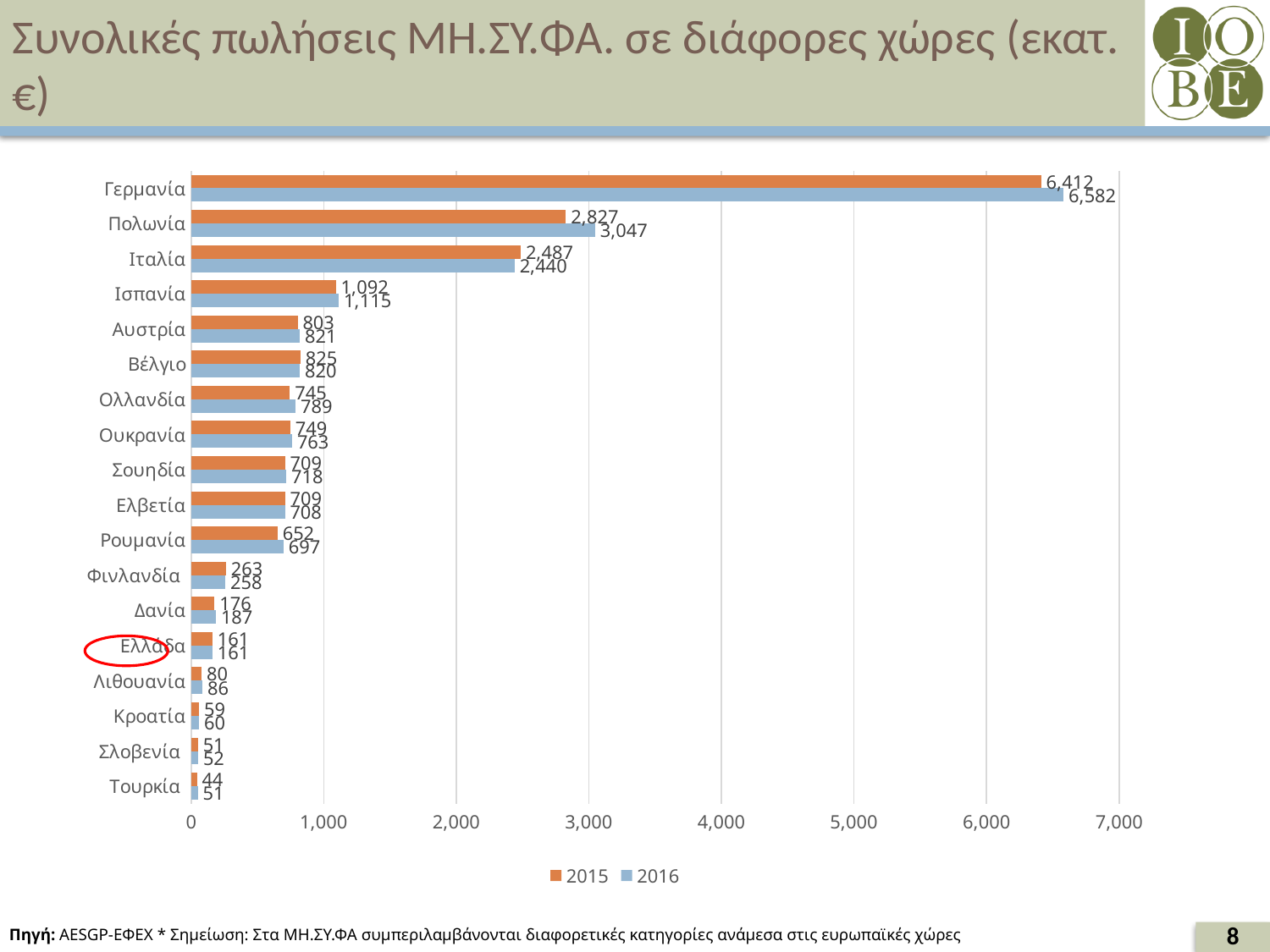
How many series does the legend list? 2 What is the value for Πολωνία in 2015? 2,827 What kind of chart is shown on the slide? Bar chart How many countries are shown in the chart? 18 What is the value for Γερμανία in 2016? 6,582 Which is larger for Ιταλία: the 2015 value or the 2016 value? 2015 Is the 2016 value for Ισπανία greater or less than 1,000? greater What is the value for Ελλάδα in 2016? 161 Which colour represents the 2015 series in the chart? Orange Which country has the highest value in 2016? Γερμανία Which country has the lowest value in 2015? Τουρκία What is the difference between the 2016 and 2015 values for Πολωνία? 220